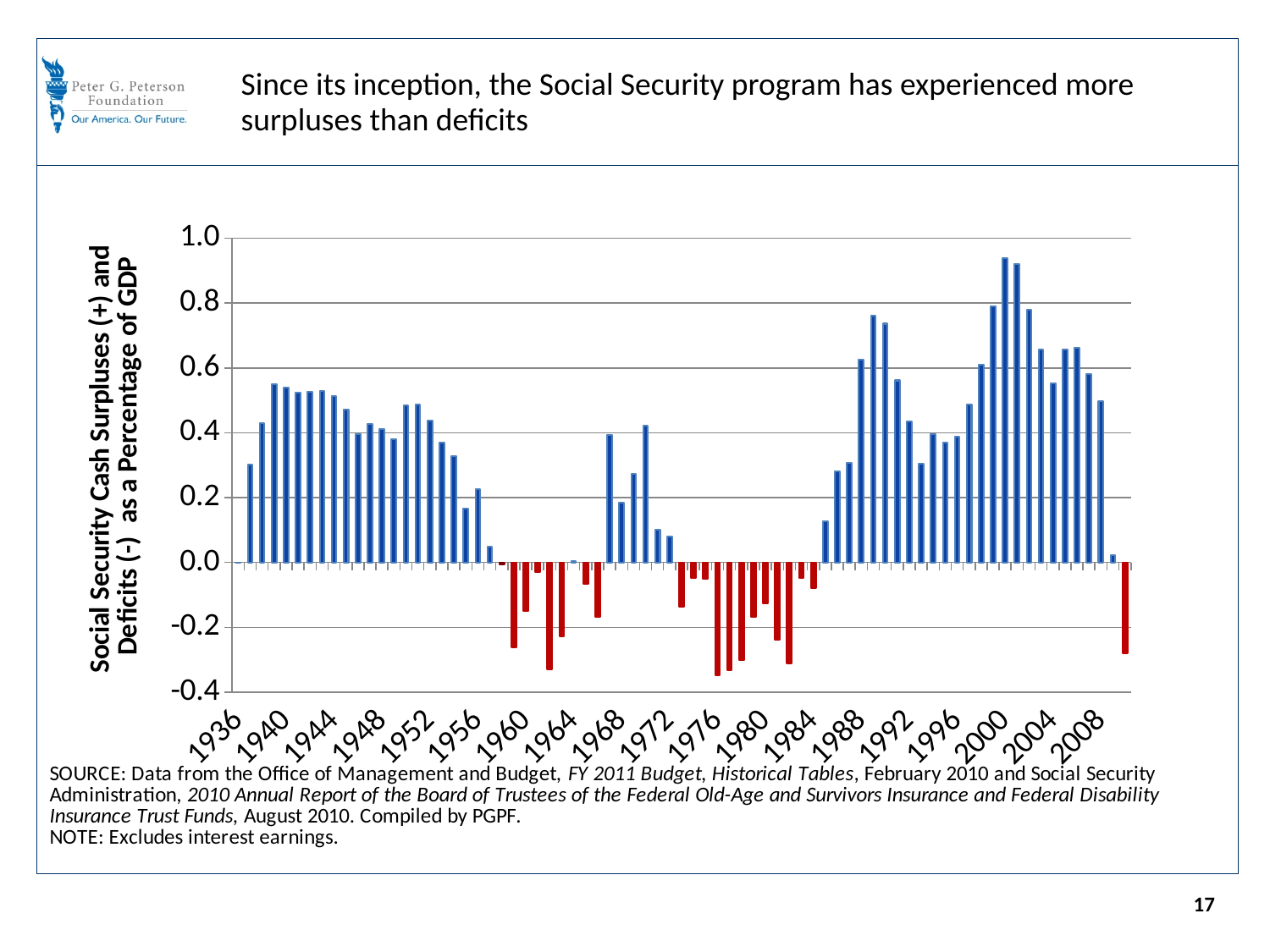
Is the value for the last year shown (the rightmost bar) positive or negative? negative Is the value for 1976 greater or less than -0.2? less What is the label of the vertical axis? Social Security Cash Surpluses (+) and Deficits (-) as a Percentage of GDP Is the value for 1992 greater or less than 0.6? less What kind of chart is shown on the slide? bar chart Do the values generally rise or fall from 1940 to 1956? fall Is the value for 2008 greater or less than 0.4? greater Which year has the larger value, 1936 or 1940? 1940 Which year has the larger value, 1968 or 1988? 1988